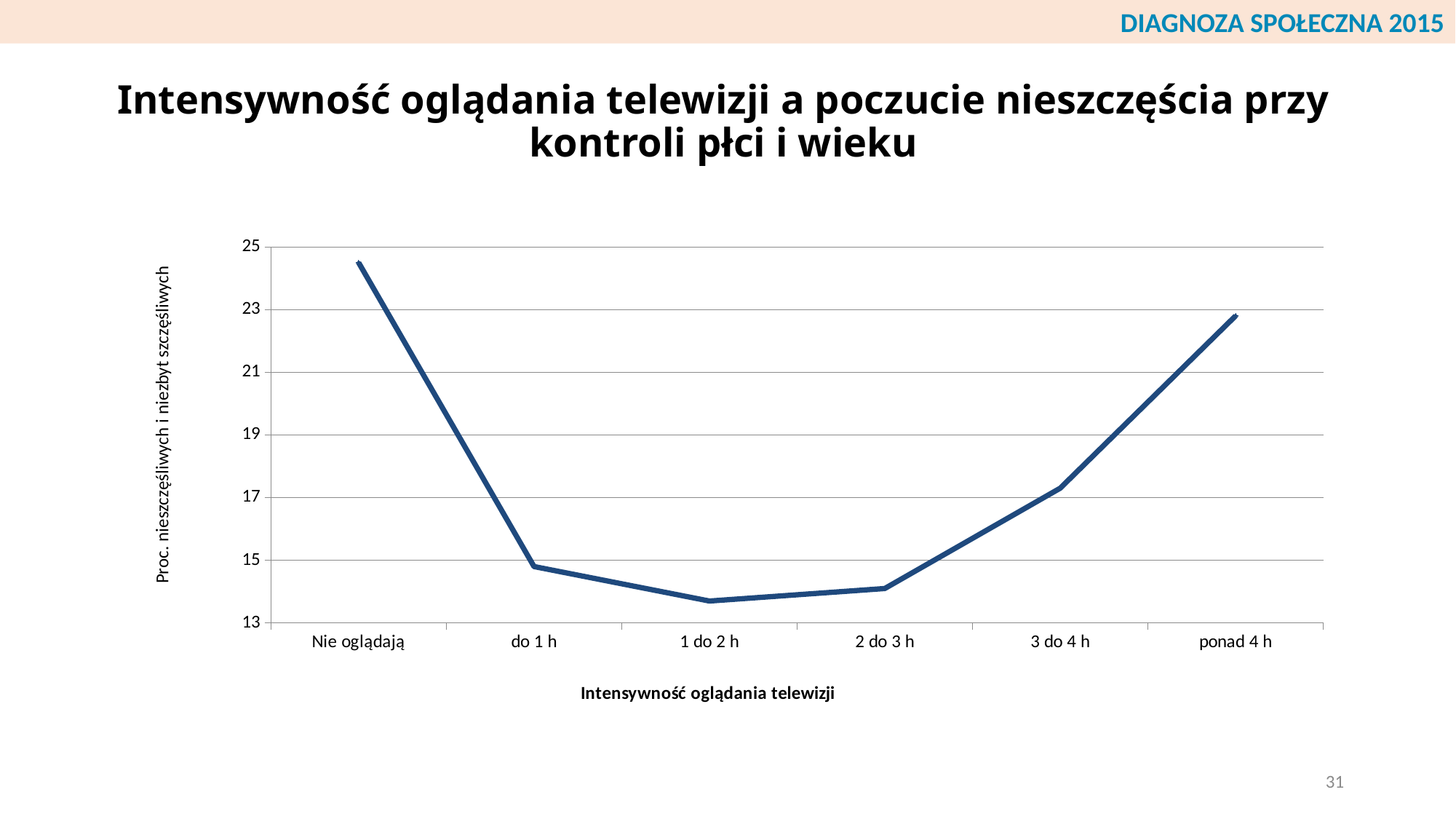
Is the value for Nie oglądają greater or less than 23? greater Do the values rise or fall from Nie oglądają to 1 do 2 h? fall Is the value for 2 do 3 h greater or less than 15? less Is the value for ponad 4 h greater or less than 21? greater Which category has the highest value on the chart? Nie oglądają How many categories are shown on the x axis of the chart? 6 Which is larger, the value for Nie oglądają or the value for ponad 4 h? Nie oglądają Which is larger, the value for 3 do 4 h or the value for do 1 h? 3 do 4 h What kind of chart is shown on the slide? line chart What is the title of the x axis of the chart? Intensywność oglądania telewizji Which category has the lowest value on the chart? 1 do 2 h